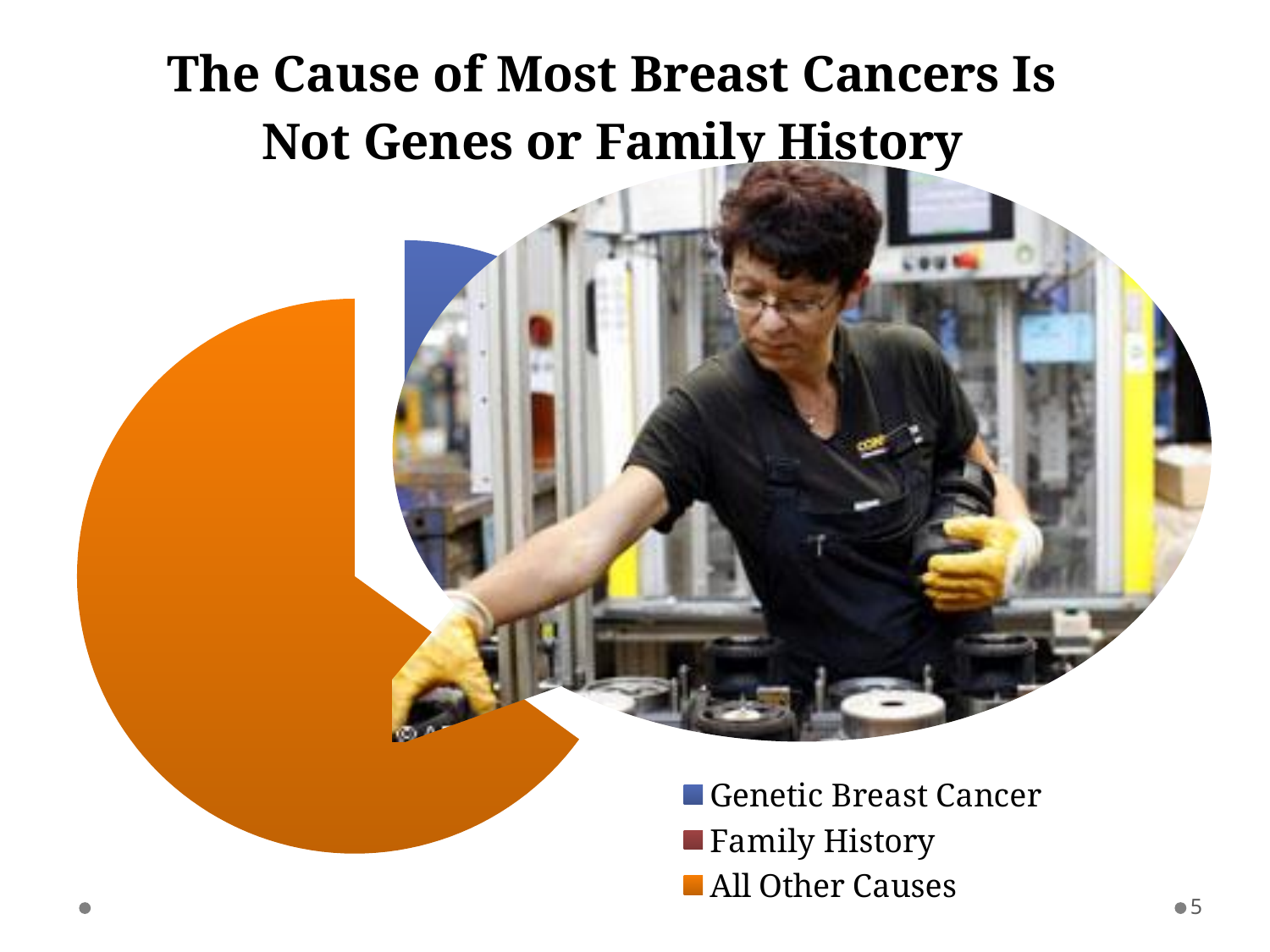
What kind of chart is shown on the slide? Pie chart How many categories does the pie chart's legend list? 3 What is the title of the slide containing the pie chart? The Cause of Most Breast Cancers Is Not Genes or Family History What colour represents All Other Causes in the pie chart? Orange Which legend entry in the pie chart is shown in blue? Genetic Breast Cancer Which category has the largest slice of the pie chart? All Other Causes Which is larger in the pie chart, the slice for All Other Causes or the slice for Genetic Breast Cancer? All Other Causes